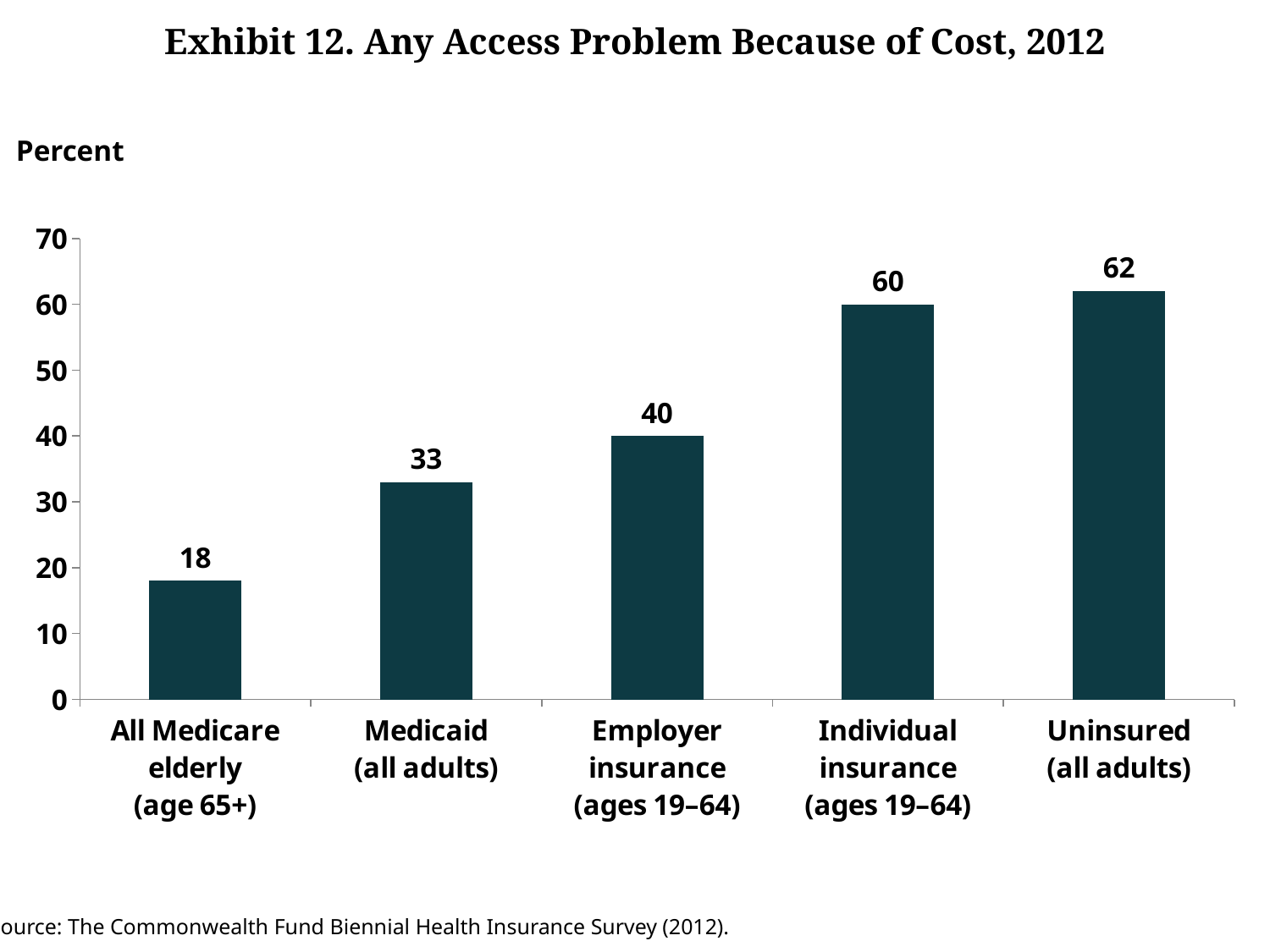
What is the value for Employer insurance (ages 19–64)? 40 What is the value for All Medicare elderly (age 65+)? 18 What is the value for Medicaid (all adults)? 33 How many categories are shown on the chart? 5 What is the difference between the values for Uninsured (all adults) and Individual insurance (ages 19–64)? 2 Is the value for Individual insurance (ages 19–64) greater or less than 50? greater What is the title of the chart? Exhibit 12. Any Access Problem Because of Cost, 2012 What is the difference between the values for Employer insurance (ages 19–64) and All Medicare elderly (age 65+)? 22 Which is larger, the value for Medicaid (all adults) or the value for Employer insurance (ages 19–64)? Employer insurance (ages 19–64) What kind of chart is shown on the slide? Bar chart Which category has the lowest value? All Medicare elderly (age 65+) Which category has the highest value? Uninsured (all adults)